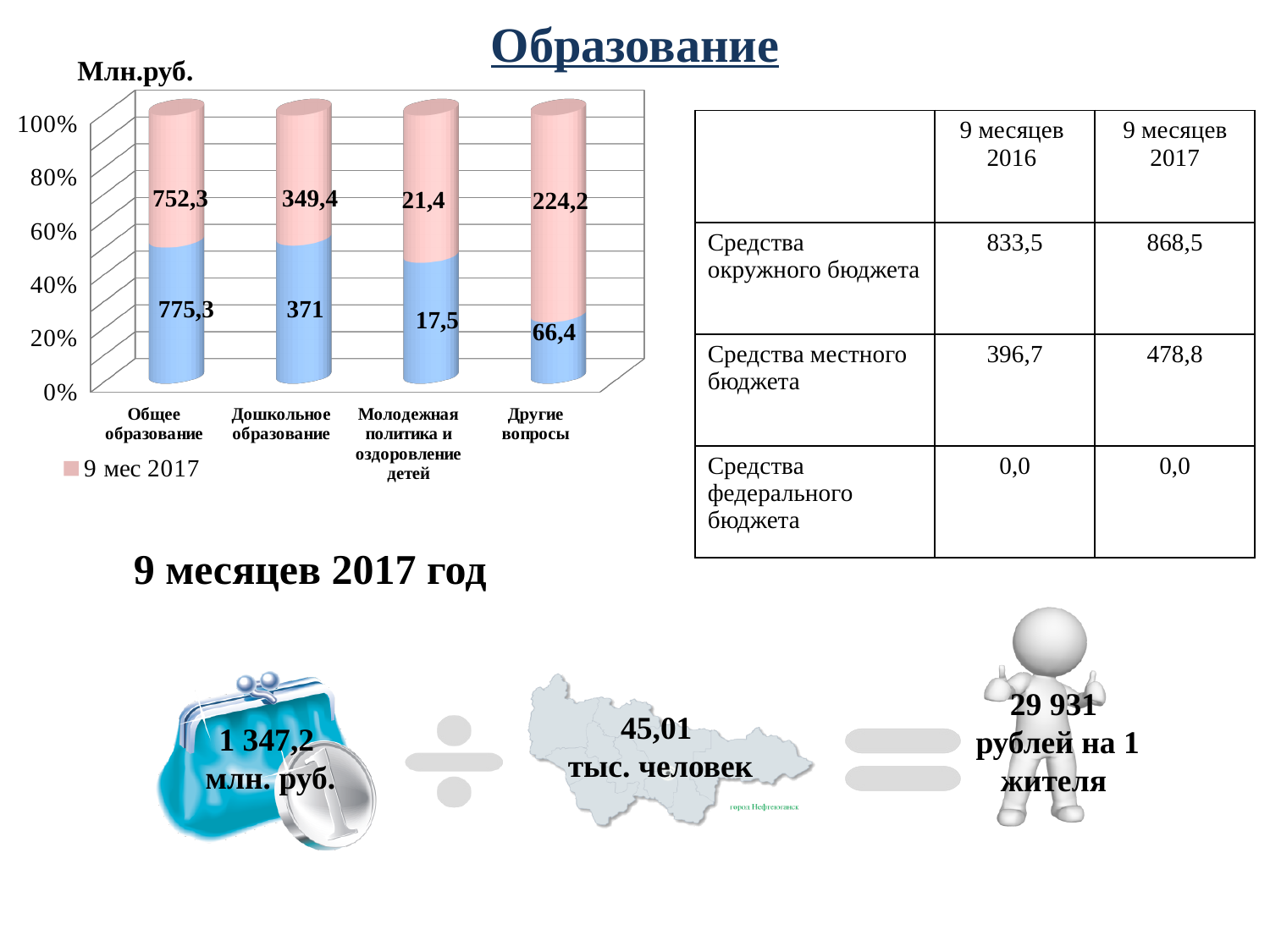
Which category has the lowest value for 9 мес 2017? Молодежная политика и оздоровление детей Which category has the highest value for 9 мес 2017? Общее образование What is the difference between the 9 мес 2017 values for Общее образование and Дошкольное образование? 402,9 What is the value for 9 мес 2017 for Другие вопросы? 224,2 Which is larger for 9 мес 2017: Другие вопросы or Дошкольное образование? Дошкольное образование What value is printed on the lower (blue) segment of the bar for Молодежная политика и оздоровление детей? 17,5 What kind of chart is shown on the slide? Stacked bar chart What unit label is shown above the chart's vertical axis? Млн.руб. What is the value for 9 мес 2017 for Дошкольное образование? 349,4 How many series does the chart legend list? 1 What is the value for 9 мес 2017 for Общее образование? 752,3 How many categories are shown on the x axis of the chart? 4